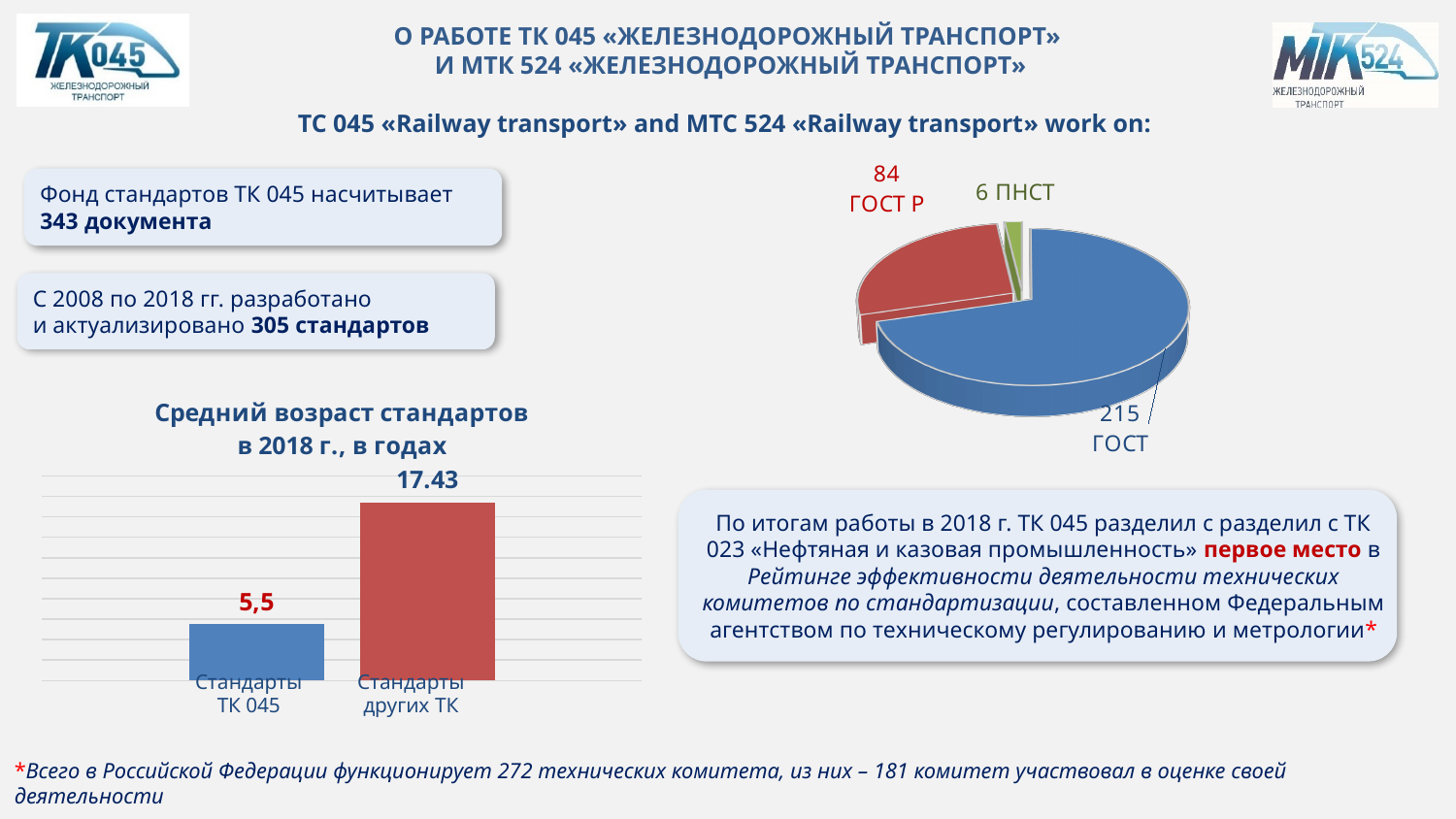
In the pie chart on the right of the slide, which slice is the largest? ГОСТ In the bar chart 'Средний возраст стандартов в 2018 г., в годах', what is the value for 'Стандарты других ТК'? 17.43 In the bar chart 'Средний возраст стандартов в 2018 г., в годах', what is the value for 'Стандарты ТК 045'? 5,5 In the pie chart on the right of the slide, what is the difference between the values for 'ГОСТ' and 'ГОСТ Р'? 131 In the bar chart 'Средний возраст стандартов в 2018 г., в годах', how many categories are shown? 2 What kind of chart is the one titled 'Средний возраст стандартов в 2018 г., в годах'? bar chart In the pie chart on the right of the slide, what is the value for 'ГОСТ'? 215 In the pie chart on the right of the slide, what is the value for 'ГОСТ Р'? 84 In the bar chart 'Средний возраст стандартов в 2018 г., в годах', which category has the higher value? Стандарты других ТК In the pie chart on the right of the slide, what is the value for 'ПНСТ'? 6 In the pie chart on the right of the slide, which slice is the smallest? ПНСТ In the bar chart 'Средний возраст стандартов в 2018 г., в годах', which category has the lower value? Стандарты ТК 045